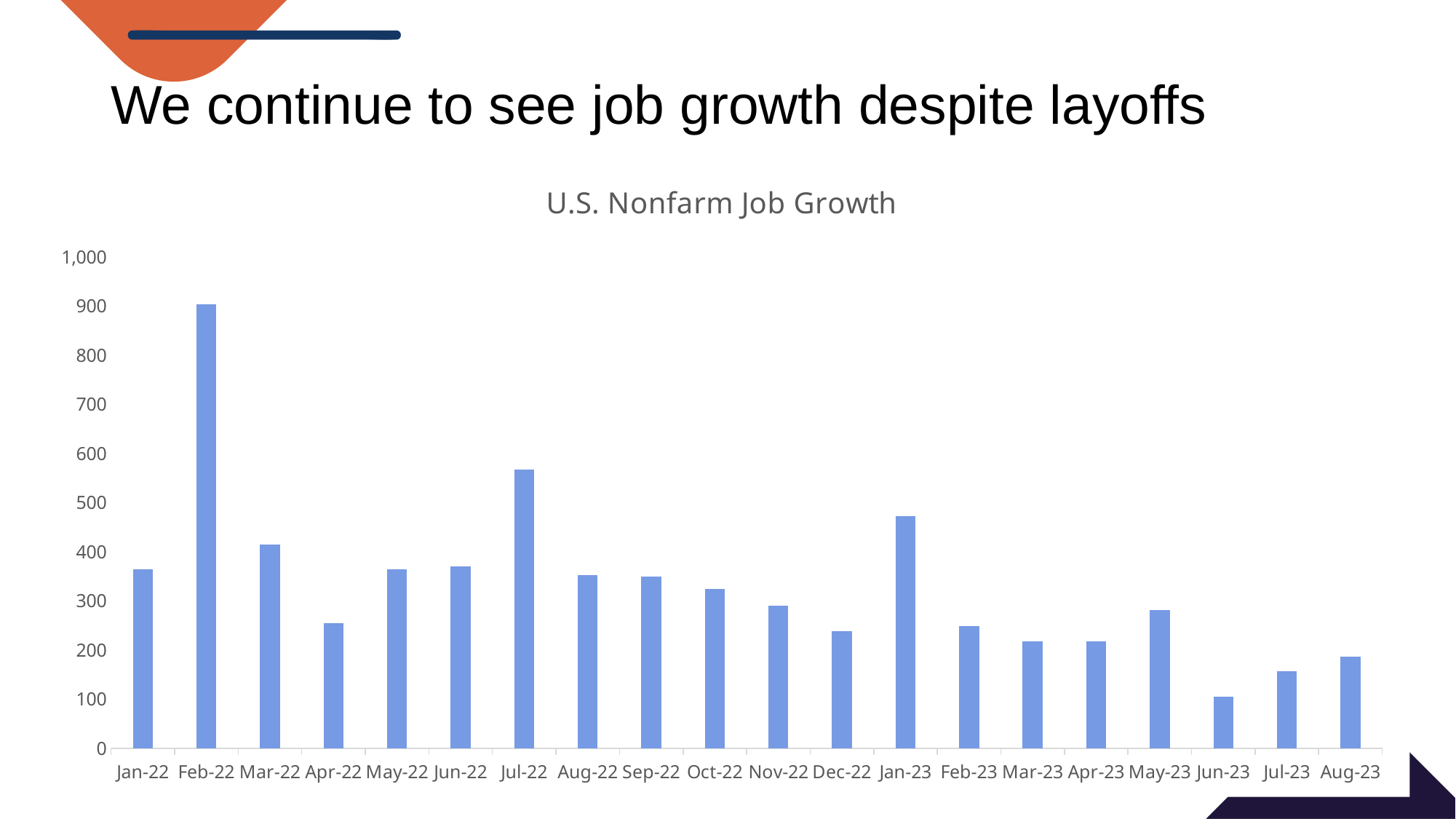
Which month has the highest job growth? Feb-22 Is the value for Jun-23 greater or less than 200? less What kind of chart is shown on the slide? Bar chart Is the value for Apr-22 greater or less than 300? less How many months are plotted on the x axis? 20 Is the value for Feb-22 greater or less than 800? greater Which month has the lowest job growth? Jun-23 What is the title of the chart? U.S. Nonfarm Job Growth Overall, do the values rise or fall from Jan-22 to Aug-23? Fall Which is larger, the value for Jul-22 or the value for Jan-23? Jul-22